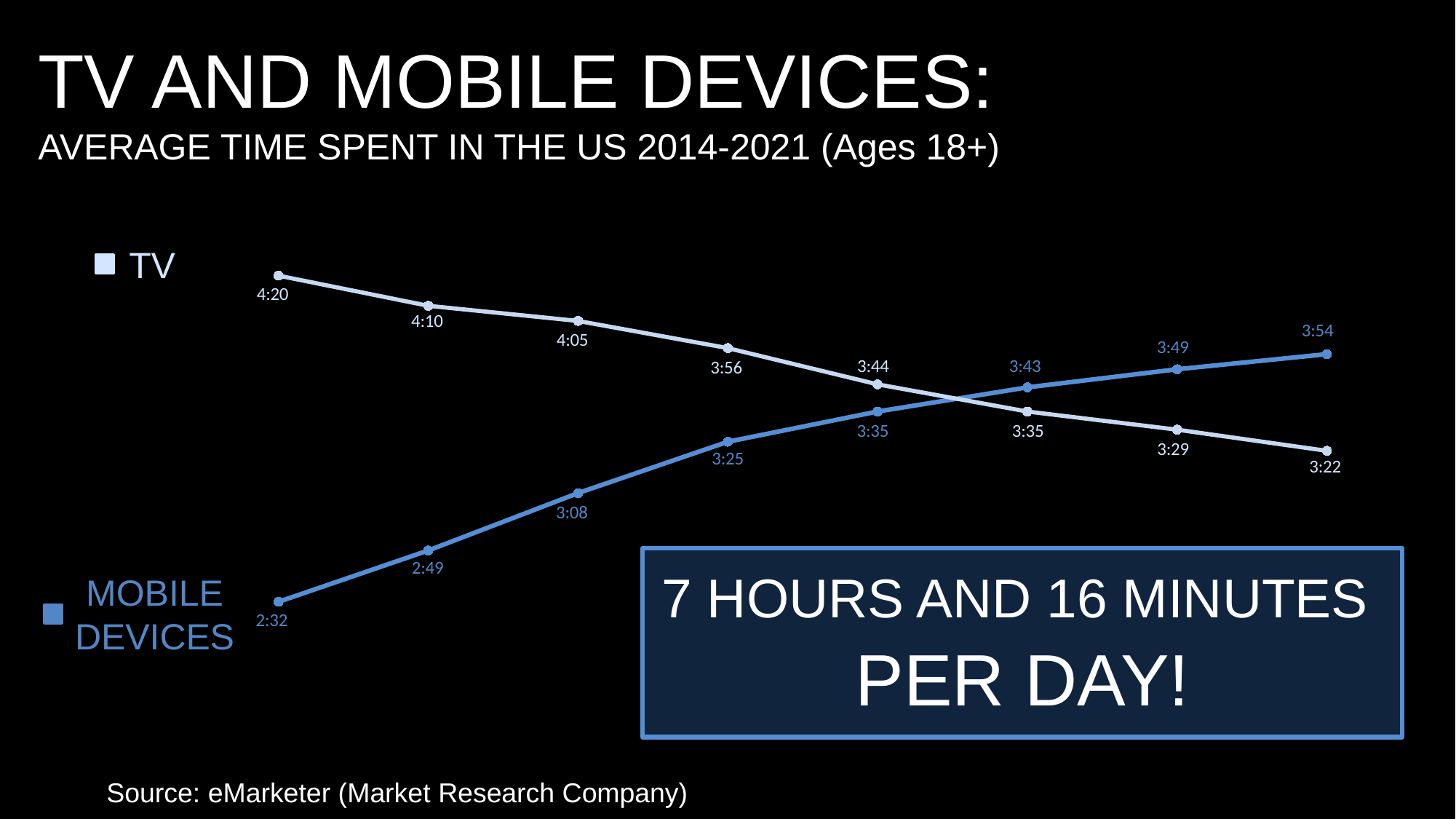
What are the two series named in the legend? TV and Mobile Devices At the rightmost point, which series has the higher value, TV or Mobile Devices? Mobile Devices What is the highest value on the TV line? 4:20 What kind of chart is shown on the slide? Line chart What is the value of the first (leftmost) point on the TV line? 4:20 What is the value of the last (rightmost) point on the Mobile Devices line? 3:54 Do the values on the TV line rise or fall from left to right? Fall What is the difference between the TV value and the Mobile Devices value at the rightmost point (3:22 vs 3:54)? 32 minutes Do the values on the Mobile Devices line rise or fall from left to right? Rise How many series does the legend list? 2 What is the lowest value on the Mobile Devices line? 2:32 How many data points does the TV line have? 8